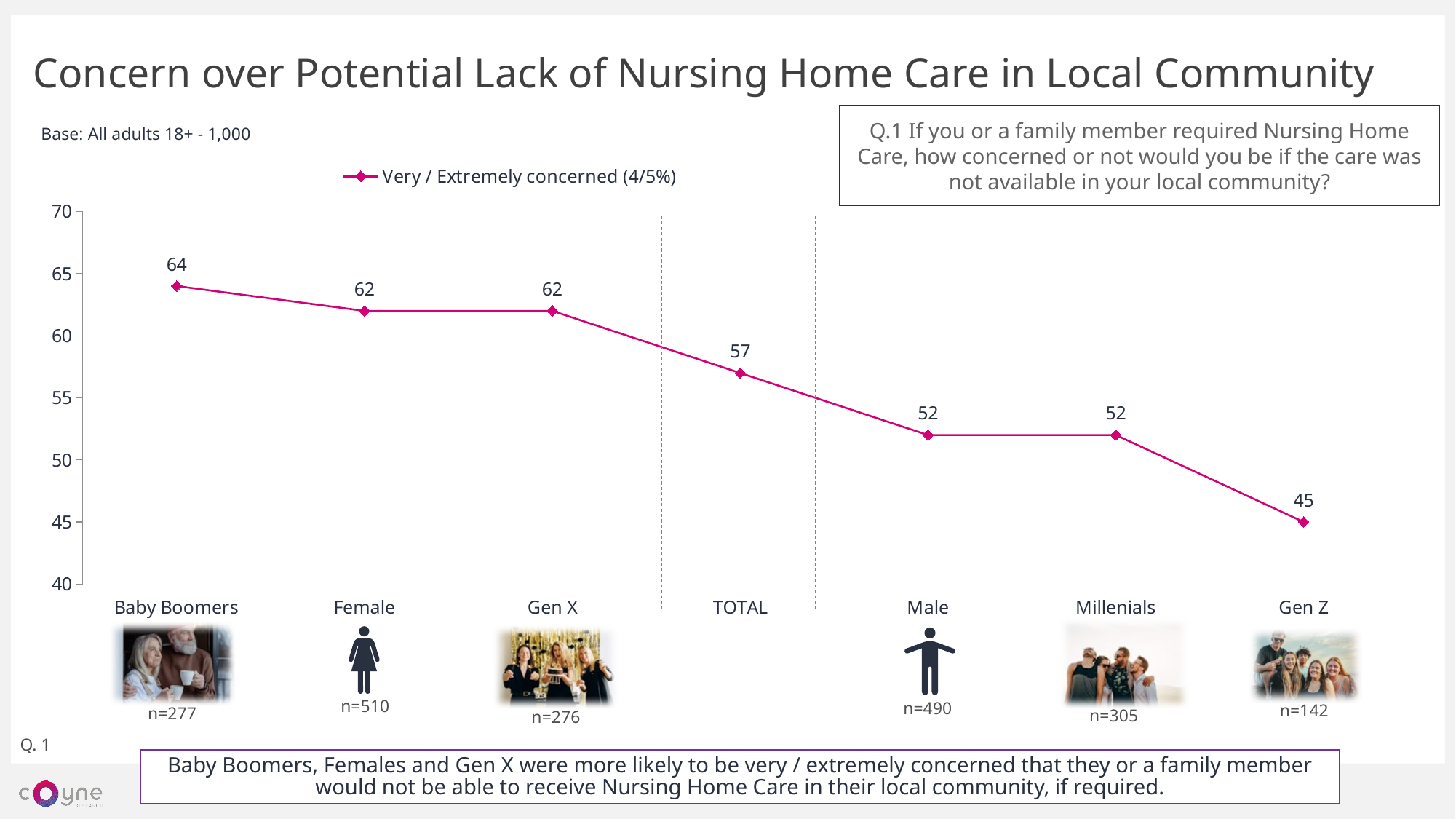
Which category has the highest value? Baby Boomers How many categories are plotted on the chart? 7 What is the legend entry for the plotted series? Very / Extremely concerned (4/5%) What is the value for TOTAL? 57 What is the value for Gen Z? 45 Which category has the lowest value? Gen Z Which is larger, the value for Gen X or the value for Millenials? Gen X What is the difference between the values for Baby Boomers and Gen Z? 19 What is the value for Male? 52 What is the difference between the values for Female and Male? 10 What kind of chart is shown on the slide? Line chart What is the value for Baby Boomers? 64